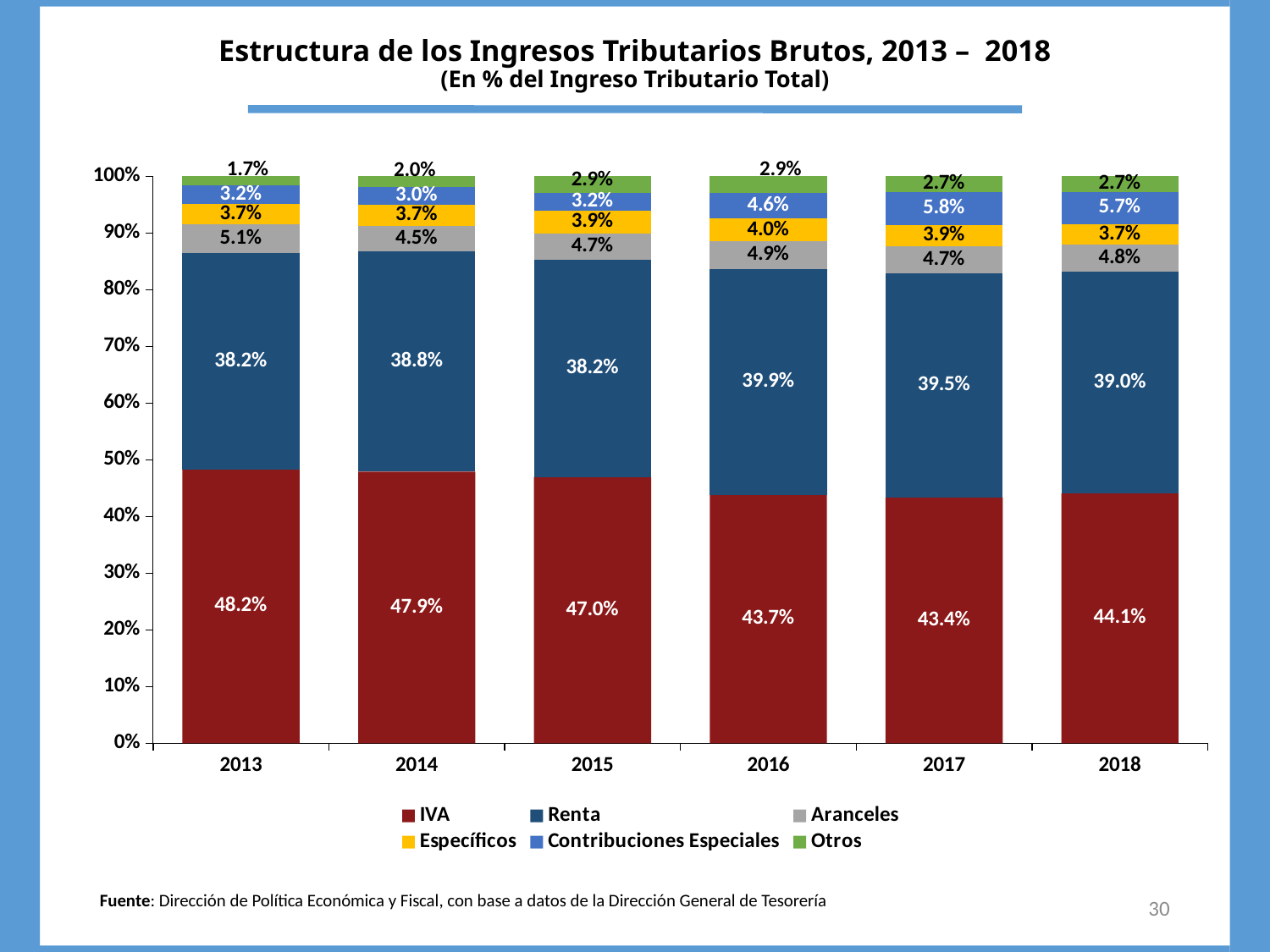
Which is larger, the Renta share in 2014 or in 2015? 2014 What is the difference between the IVA share in 2013 and in 2018? 4.1% What is the Otros share in 2013? 1.7% What is the Renta share in 2016? 39.9% How many series does the legend list? 6 In which year is the IVA share the highest? 2013 What is the IVA share in 2013? 48.2% Does the Contribuciones Especiales share rise or fall from 2014 to 2017? Rise What kind of chart is shown on the slide? Stacked bar chart How many years are shown on the x axis? 6 What is the Contribuciones Especiales share in 2017? 5.8% In which year is the IVA share the lowest? 2017